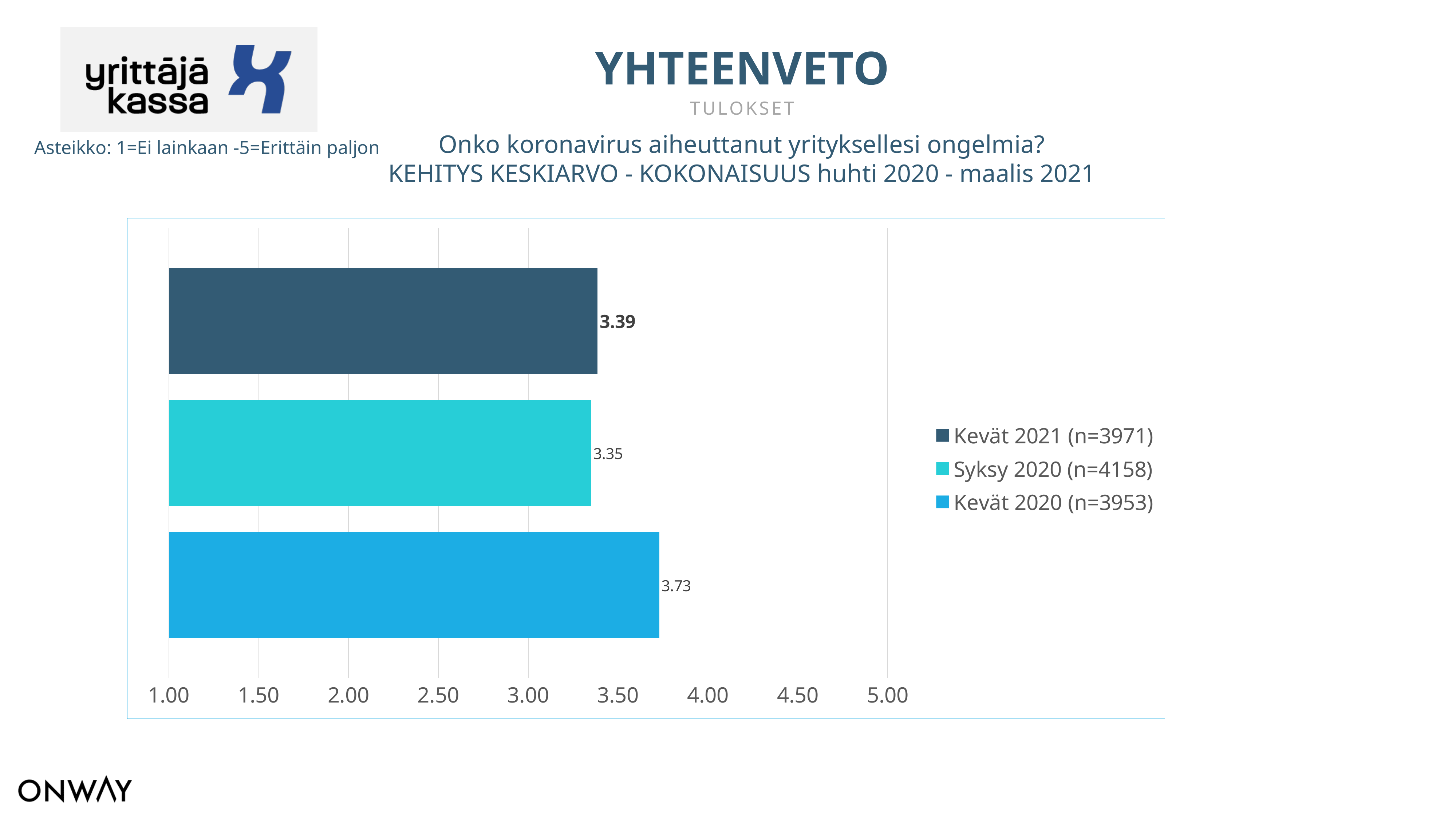
What is the value for Kevät 2020 (n=3953)? 3.73 What is the sample size (n) shown in the legend for Syksy 2020? 4158 What is the value for Syksy 2020 (n=4158)? 3.35 Is the value for Kevät 2020 greater or less than 3.50? greater What kind of chart is shown on the slide? bar chart What is the value for Kevät 2021 (n=3971)? 3.39 How many series does the legend list? 3 What is the difference between the values for Kevät 2021 and Syksy 2020? 0.04 Which series has the lowest value? Syksy 2020 (n=4158) What is the difference between the values for Kevät 2020 and Kevät 2021? 0.34 Which is larger, the value for Kevät 2020 or the value for Syksy 2020? Kevät 2020 Which series has the highest value? Kevät 2020 (n=3953)